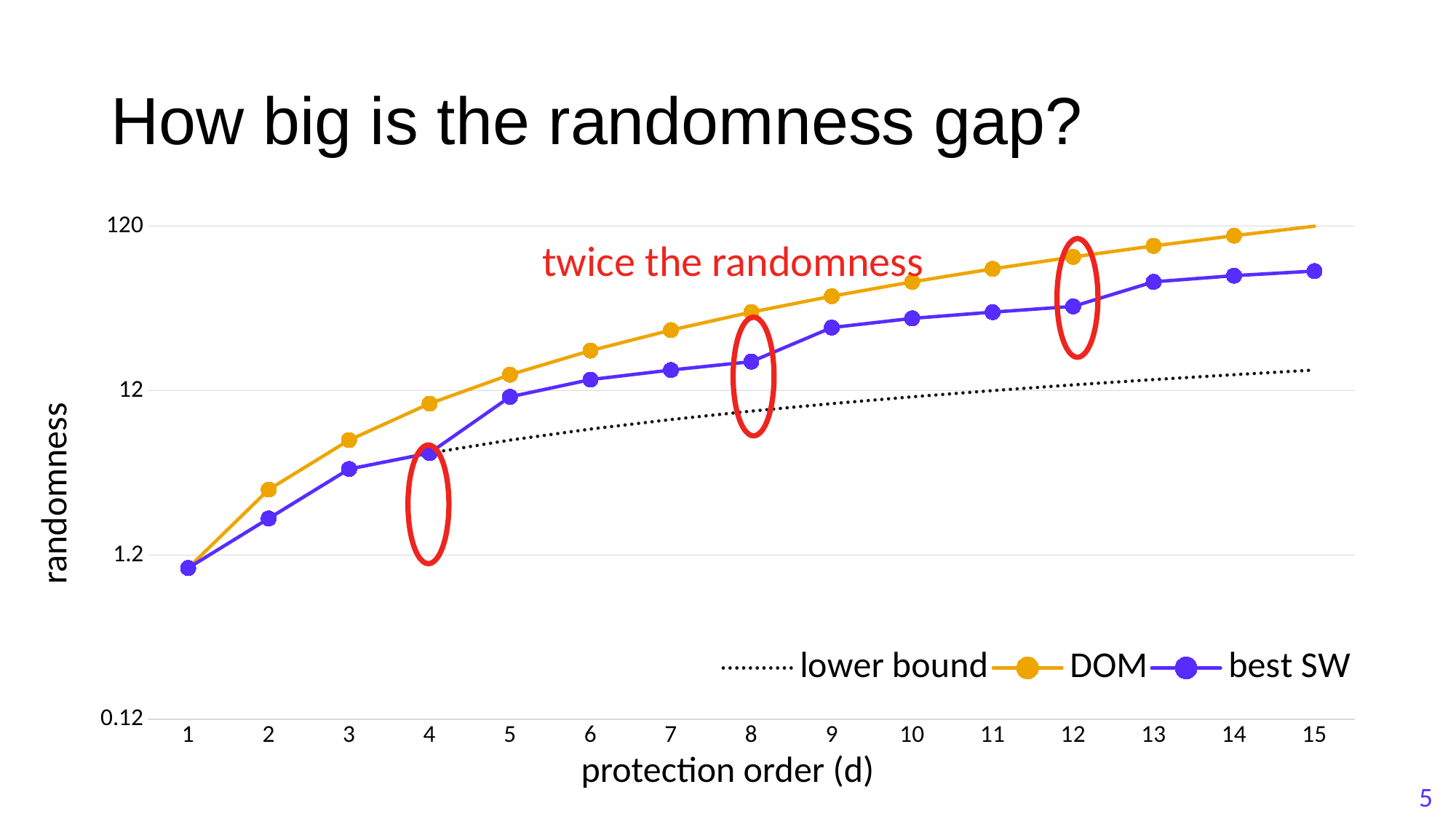
Is the DOM value at protection order 4 greater or less than 12? less Is the best SW value at protection order 15 greater or less than 120? less What kind of chart is shown on the slide? line chart What annotation text is written in red above the lines? twice the randomness At protection order 12, which series has the higher randomness, DOM or best SW? DOM Does the best SW series rise or fall as the protection order increases? rise At protection order 8, which series has the lower randomness, best SW or lower bound? lower bound How many series does the legend list? 3 How many protection order values are shown on the x axis? 15 Is the DOM value at protection order 8 greater or less than 12? greater What is the label of the y axis? randomness Does the DOM series rise or fall as the protection order increases? rise